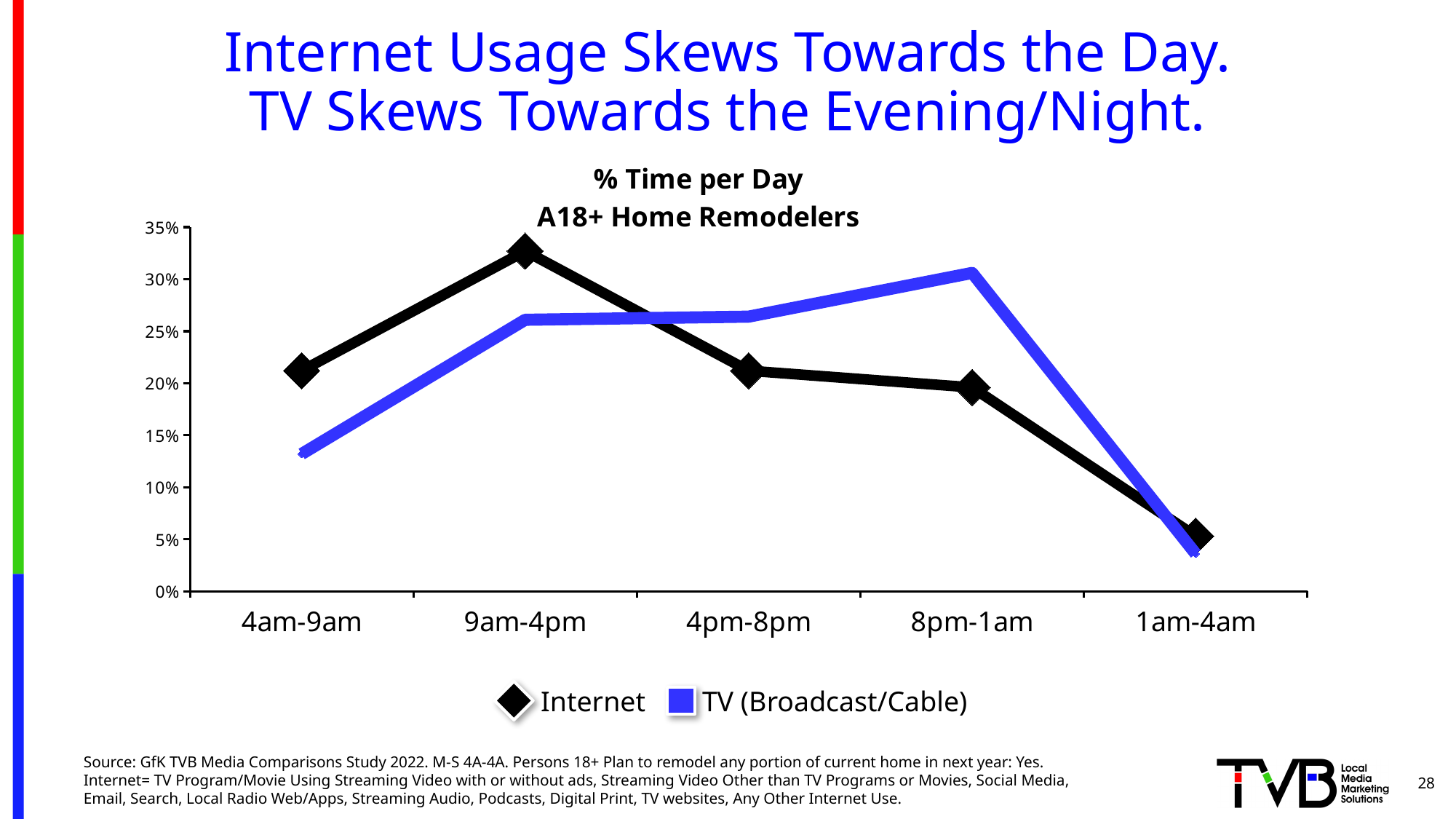
How many series does the legend list? 2 What kind of chart is shown on the slide? line chart Is the Internet value for 1am-4am greater or less than 10%? less Which series has the larger value at 4am-9am, Internet or TV (Broadcast/Cable)? Internet How many time periods are shown on the x axis? 5 Is the TV (Broadcast/Cable) value for 4am-9am greater or less than 15%? less Is the Internet value for 9am-4pm greater or less than 30%? greater In which time period is TV (Broadcast/Cable) usage highest? 8pm-1am In which time period is Internet usage lowest? 1am-4am Does the Internet line rise or fall from 9am-4pm to 1am-4am? fall In which time period is Internet usage highest? 9am-4pm Which series has the larger value at 8pm-1am, Internet or TV (Broadcast/Cable)? TV (Broadcast/Cable)